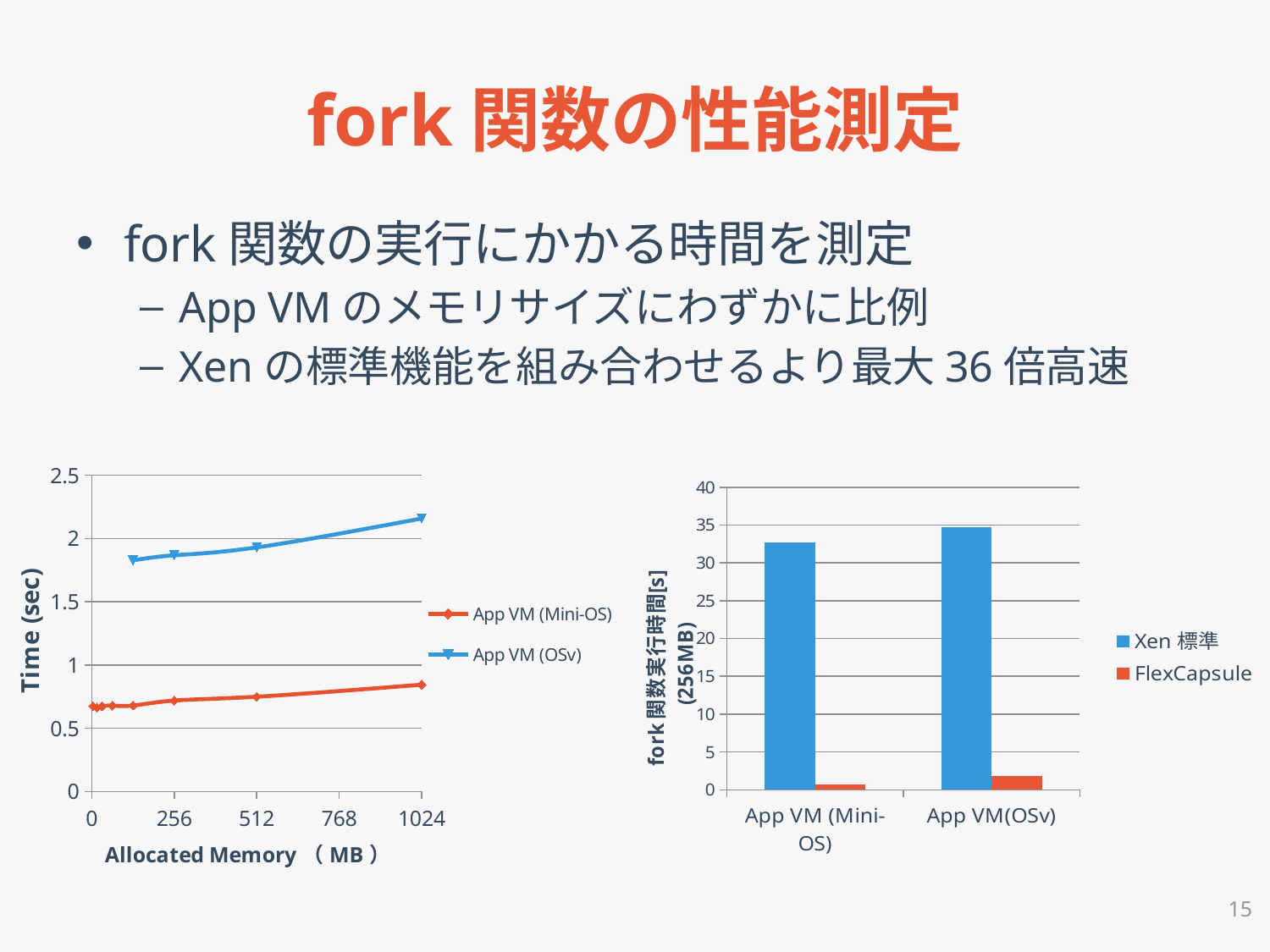
In the left chart, how many series does the legend list? 2 In the right chart, how many categories are shown on the x axis? 2 In the left chart, which series has the higher time values, App VM (Mini-OS) or App VM (OSv)? App VM (OSv) In the right chart, is the Xen 標準 value for App VM(OSv) greater or less than 30? greater In the left chart, does the time for App VM (OSv) rise or fall as allocated memory increases? rise In the right chart, is the FlexCapsule value for App VM (Mini-OS) greater or less than 5? less In the right chart, how many series does the legend list? 2 What kind of chart is the chart on the right of the slide? bar chart In the right chart, which series has the larger value for App VM (Mini-OS), Xen 標準 or FlexCapsule? Xen 標準 In the left chart, is the time for App VM (OSv) at 1024 MB greater or less than 2 seconds? greater What kind of chart is the chart on the left of the slide? line chart